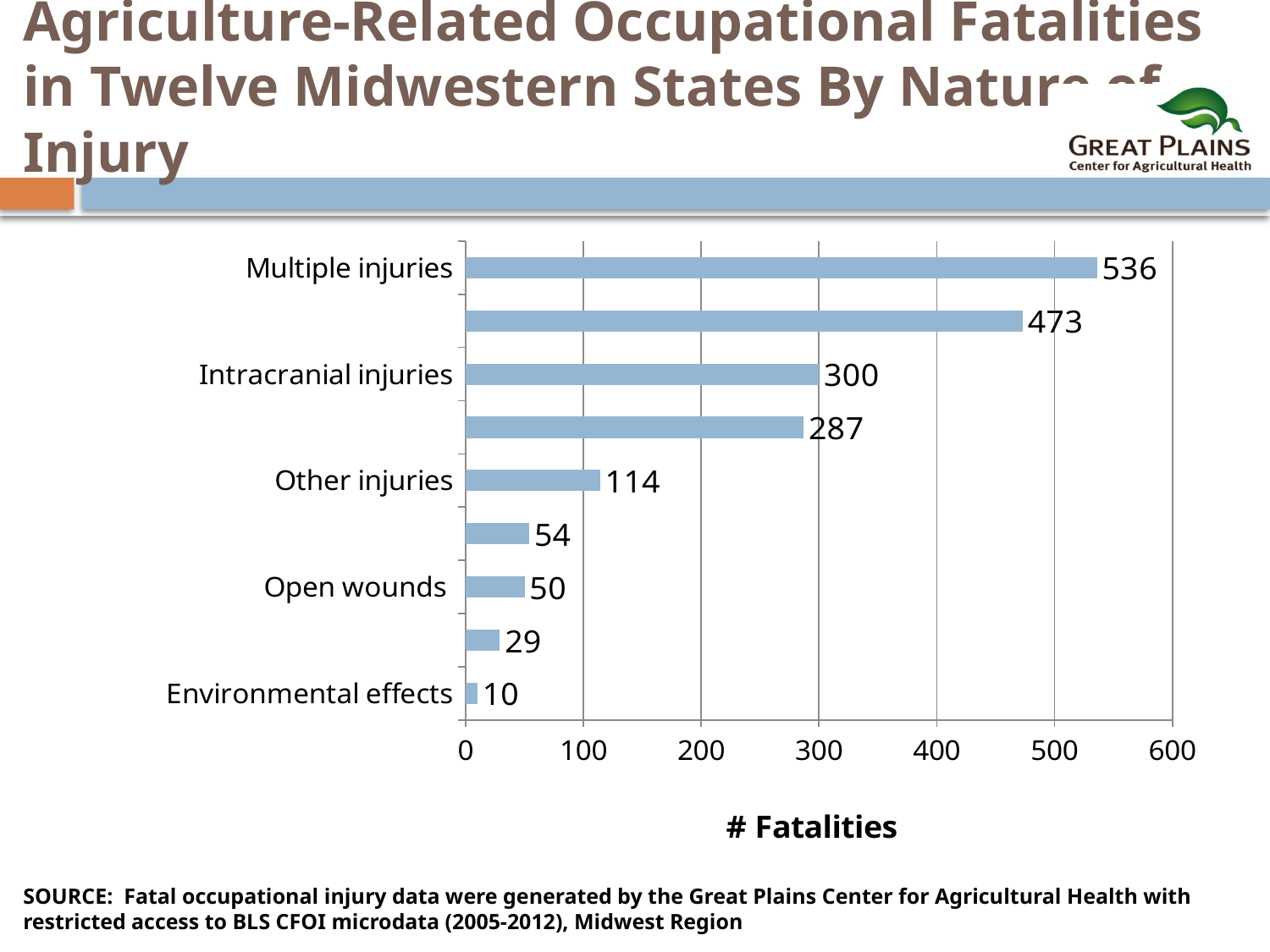
Which nature of injury has the highest number of fatalities? Multiple injuries How many fatalities are shown for Environmental effects? 10 How many bars are plotted in the chart? 9 What is the difference in fatalities between Other injuries and Open wounds? 64 What is the difference in fatalities between Multiple injuries and Intracranial injuries? 236 How many fatalities are shown for Open wounds? 50 How many fatalities are shown for Multiple injuries? 536 What type of chart is shown on the slide? Bar chart How many fatalities are shown for Other injuries? 114 How many fatalities are shown for Intracranial injuries? 300 Which nature of injury has the lowest number of fatalities? Environmental effects Which has more fatalities, Intracranial injuries or Other injuries? Intracranial injuries